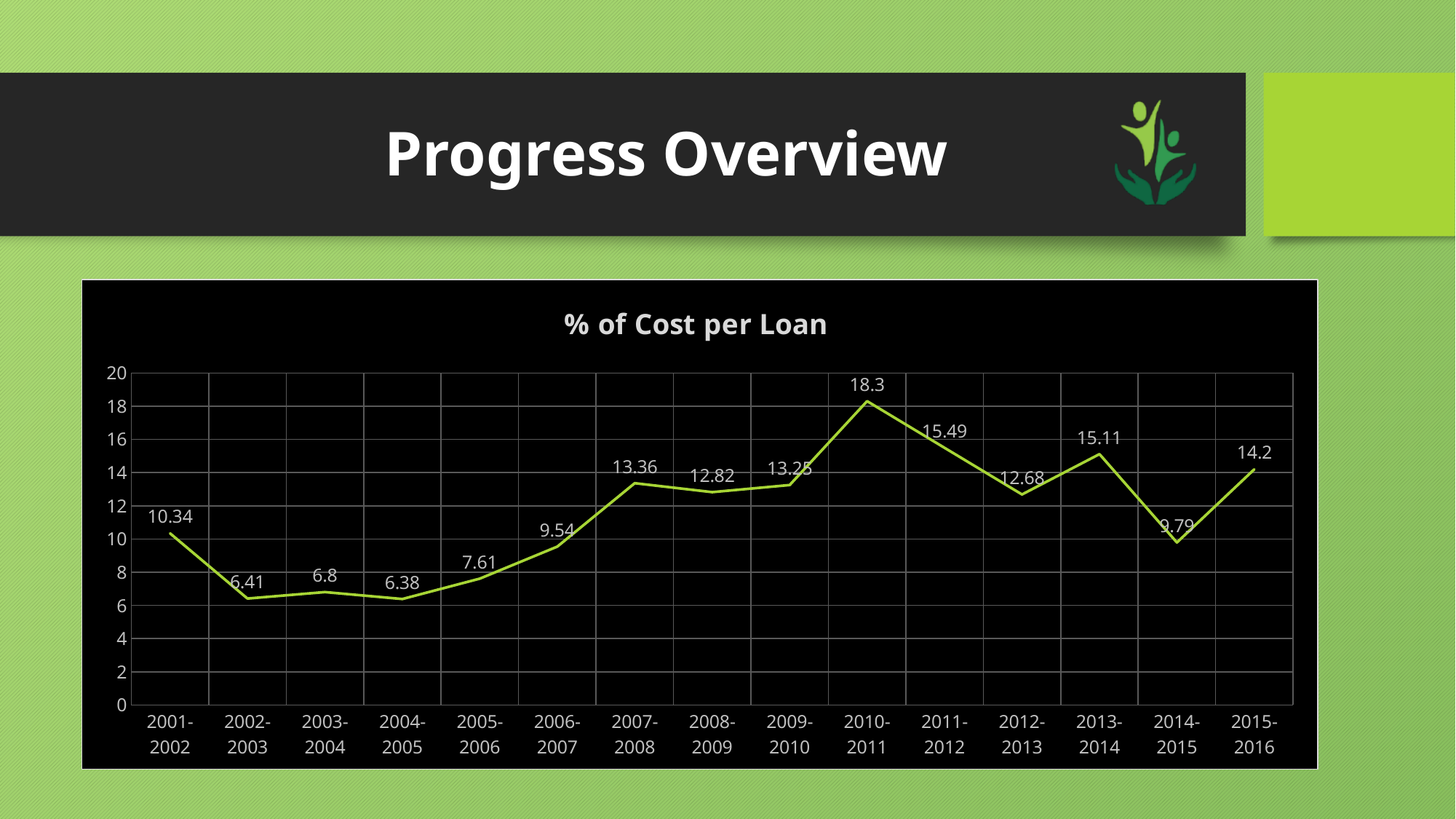
What is the value for 2010-2011? 18.3 What is the title of the chart? % of Cost per Loan Is the value for 2013-2014 greater or less than 14? greater Which year has the lowest % of cost per loan? 2004-2005 Do the values rise or fall from 2004-2005 to 2007-2008? Rise Which year has the highest % of cost per loan? 2010-2011 What is the difference between the values for 2010-2011 and 2011-2012? 2.81 How many year periods are plotted on the chart? 15 What is the value for 2015-2016? 14.2 Which is larger, the value for 2007-2008 or the value for 2008-2009? 2007-2008 What is the value for 2001-2002? 10.34 What kind of chart is shown on the slide? Line chart